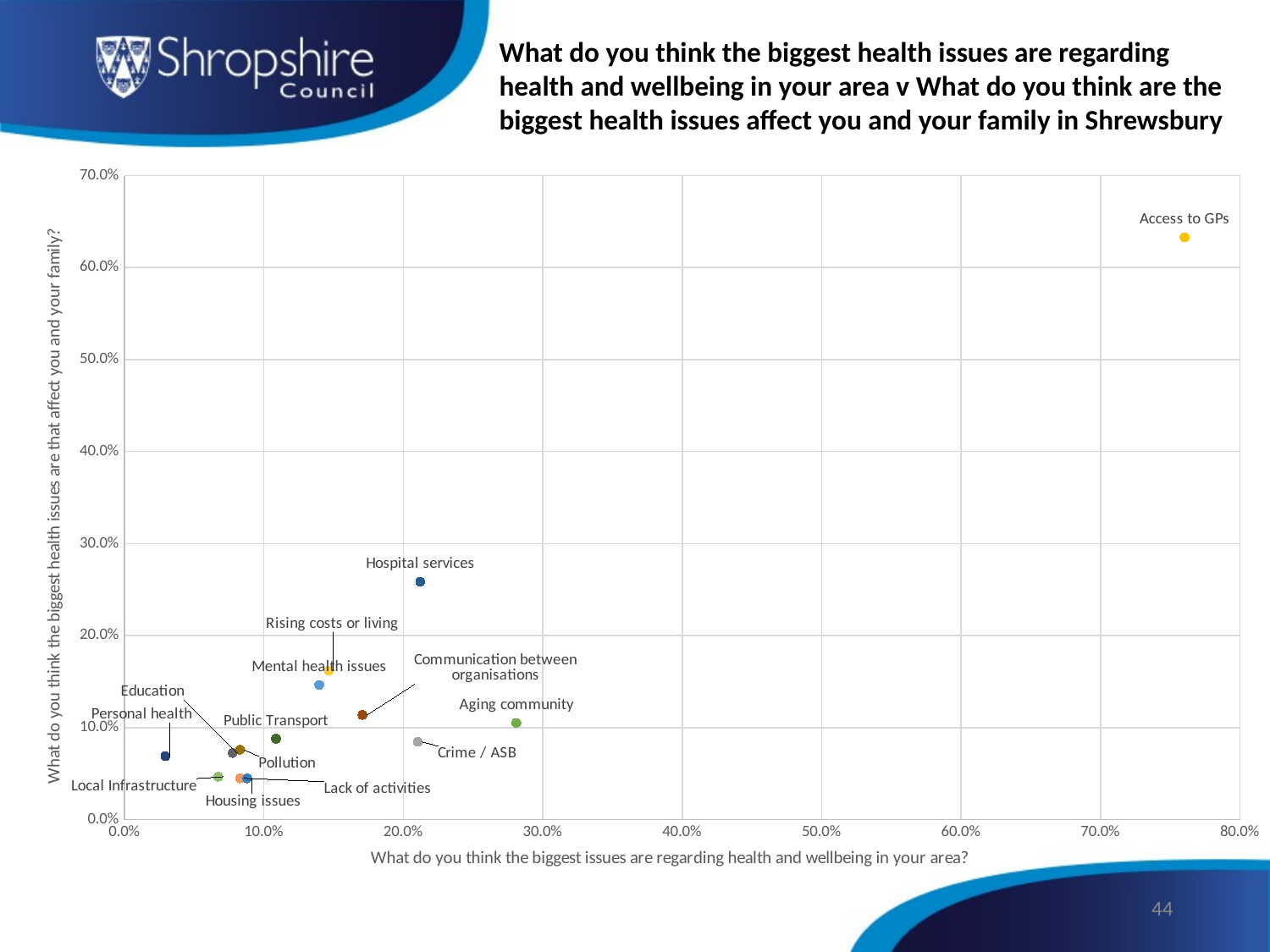
Which has the higher horizontal-axis value, Aging community or Mental health issues? Aging community What kind of chart is shown on the slide? Scatter chart Is the vertical-axis value for Access to GPs greater or less than 60.0%? greater What is the title of the horizontal axis? What do you think the biggest issues are regarding health and wellbeing in your area? Is the horizontal-axis value for Aging community greater or less than 20.0%? greater Which labelled point has the highest value on the horizontal axis (issues in your area)? Access to GPs Which labelled point has the highest value on the vertical axis (issues affecting you and your family)? Access to GPs Which labelled point has the lowest value on the horizontal axis? Personal health Is the vertical-axis value for Hospital services greater or less than 30.0%? less Which has the higher vertical-axis value, Hospital services or Aging community? Hospital services How many labelled data points are plotted on the chart? 14